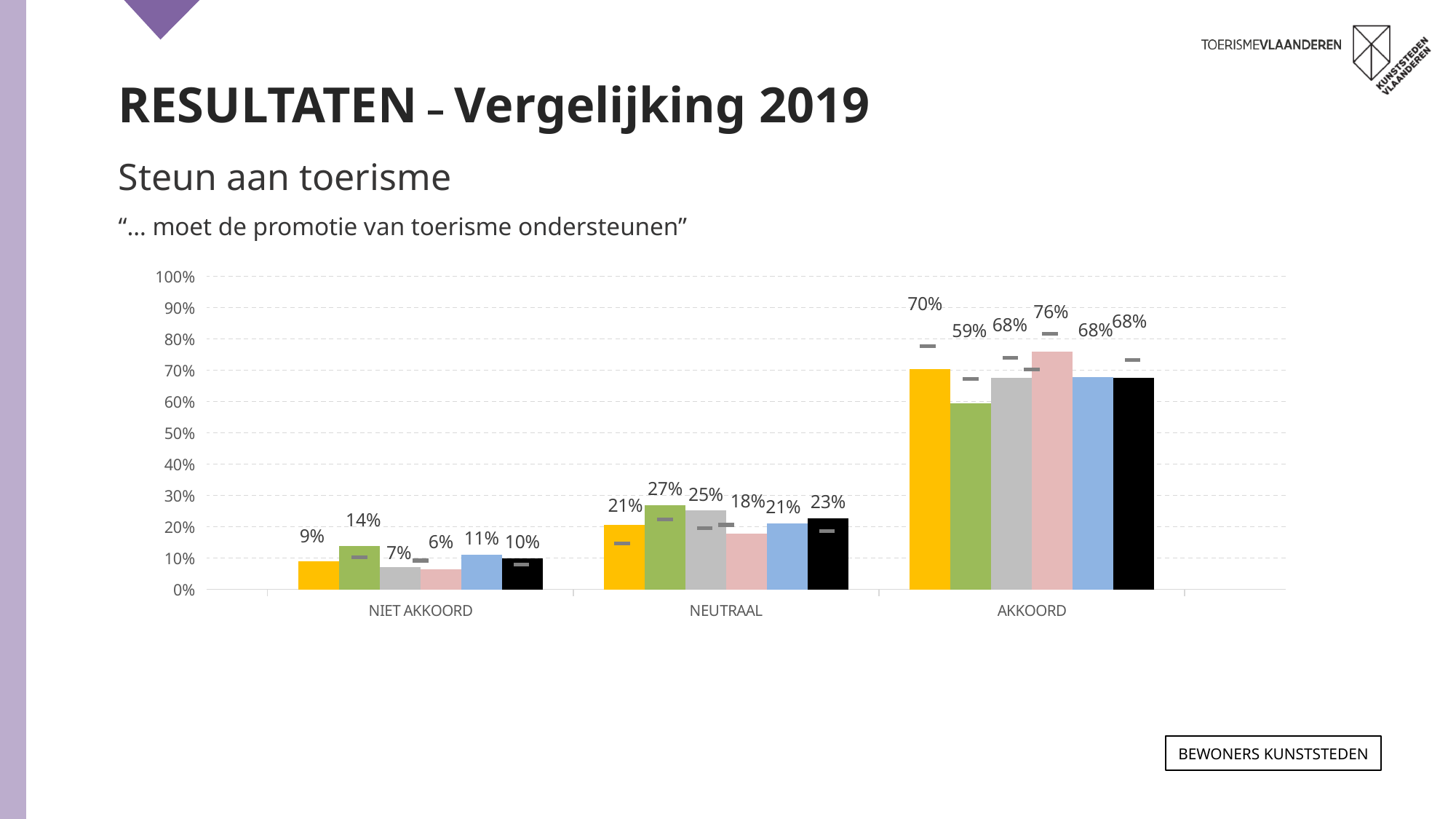
What is the value of the black bar for NEUTRAAL? 23% Is the value of the green bar for AKKOORD greater or less than 60%? less Which is larger in the NEUTRAAL category: the grey bar or the pink bar? The grey bar (25%) Which bar has the highest value in the AKKOORD category? The pink bar (76%) What is the value of the yellow bar for NIET AKKOORD? 9% What is the difference between the yellow bar and the green bar in the AKKOORD category? 11% Which bar has the lowest value in the NIET AKKOORD category? The pink bar (6%) How many categories are shown on the x axis? 3 What is the maximum value shown on the y axis? 100% What is the value of the pink bar for AKKOORD? 76% What is the value of the green bar for NEUTRAAL? 27% What kind of chart is shown on the slide? Bar chart